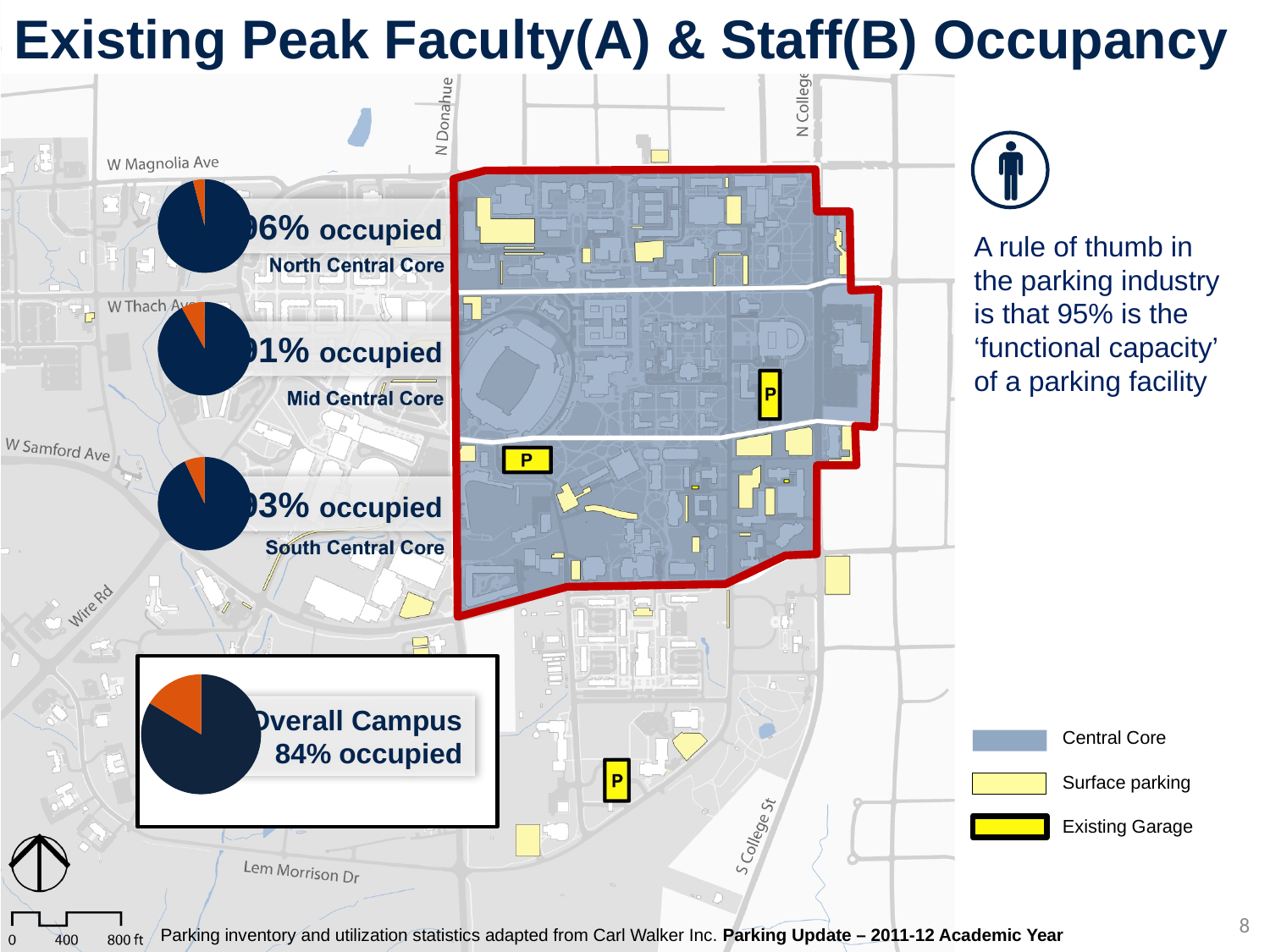
In the Overall Campus pie chart, what share of the pie is occupied? 84% Which pie chart has the largest unoccupied (orange) slice? Overall Campus In the Overall Campus pie chart, what share of the pie is not occupied? 16% What kind of charts are used to show occupancy on this slide? Pie charts Which has a higher occupancy: the North Central Core pie chart or the Overall Campus pie chart? North Central Core Which pie chart is enclosed in a white box with a black border? Overall Campus What is the occupancy percentage shown for the Overall Campus pie chart? 84% occupied How many pie charts are shown on the slide? 4 What are the labels of the three pie charts placed along the left side of the map, from top to bottom? North Central Core, Mid Central Core, South Central Core Which pie chart has the smallest unoccupied (orange) slice? North Central Core